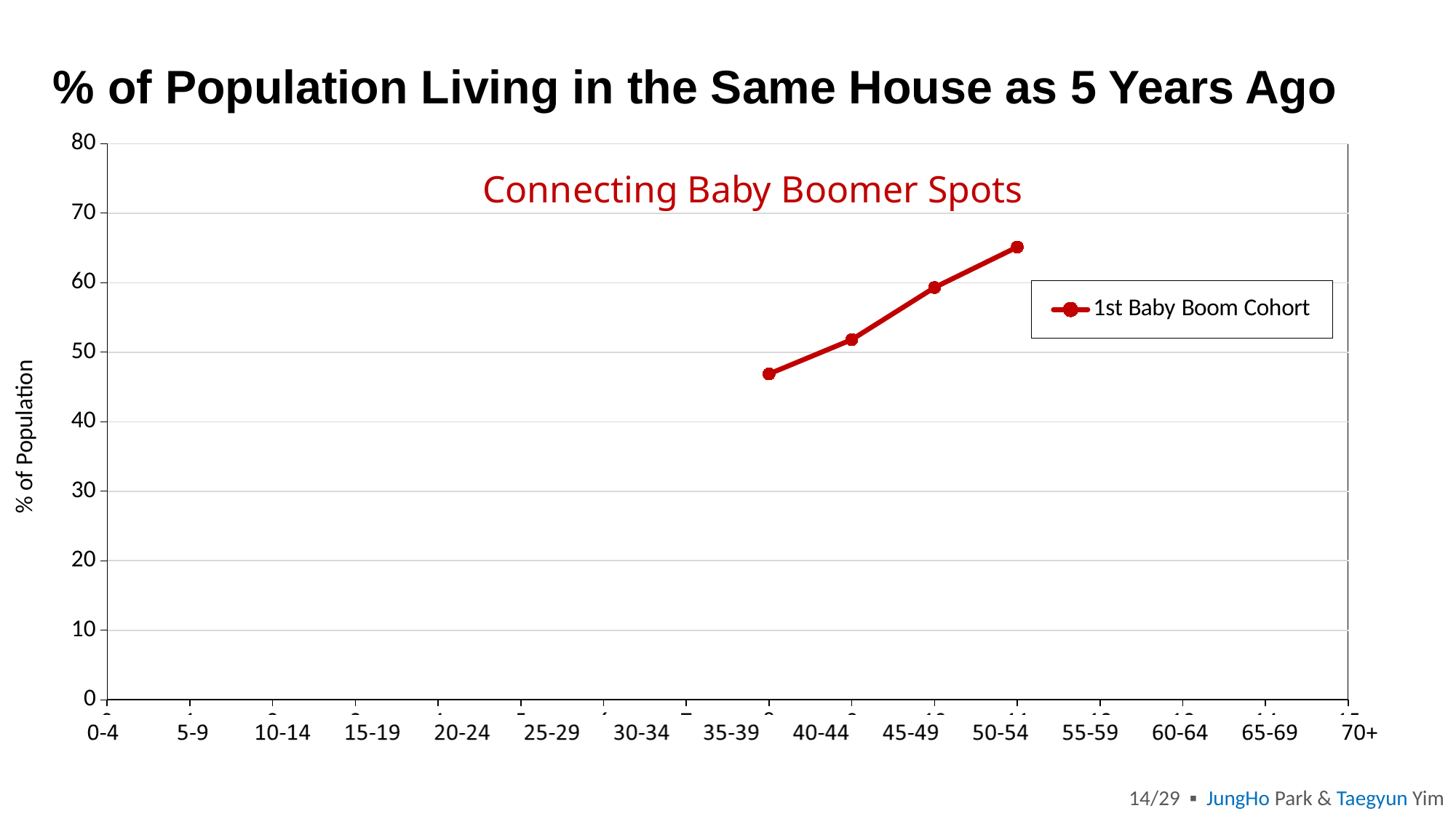
Which plotted point has the lowest value? the leftmost (first) point Is the value of the rightmost plotted point greater or less than 60? greater How many data points are plotted on the line? 4 How many series does the legend list? 1 What is the name of the series shown in the legend? 1st Baby Boom Cohort Which plotted point has the highest value? the rightmost (fourth) point Which is larger, the value of the first plotted point or the value of the last plotted point? the last plotted point What kind of chart is shown on the slide? line chart Is the value of the leftmost plotted point greater or less than 50? less Is the value of the rightmost plotted point greater or less than 70? less What is the label on the vertical axis? % of Population Do the plotted values rise or fall from left to right along the x axis? rise